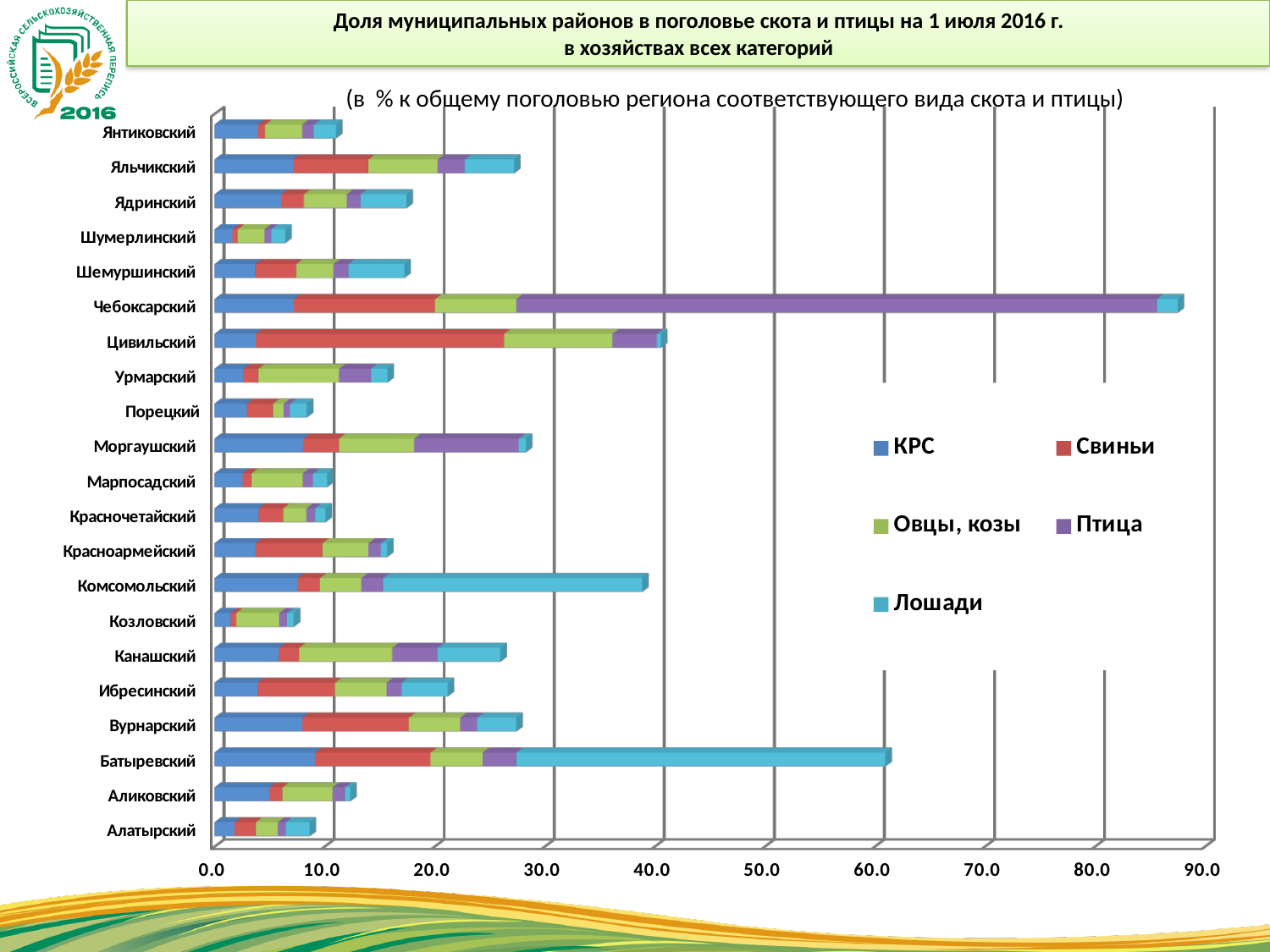
Is the total bar for Чебоксарский greater or less than 80.0? greater Which district has the longest total bar? Чебоксарский Which series is shown in purple in the legend? Птица How many series does the legend list? 5 Is the total bar for Батыревский greater or less than 50.0? greater Is the total bar for Цивильский greater or less than 30.0? greater How many municipal districts (categories) are plotted on the chart? 21 Which district has the longer total bar, Комсомольский or Канашский? Комсомольский Which district has the longer total bar, Чебоксарский or Батыревский? Чебоксарский What kind of chart is shown on the slide? bar chart